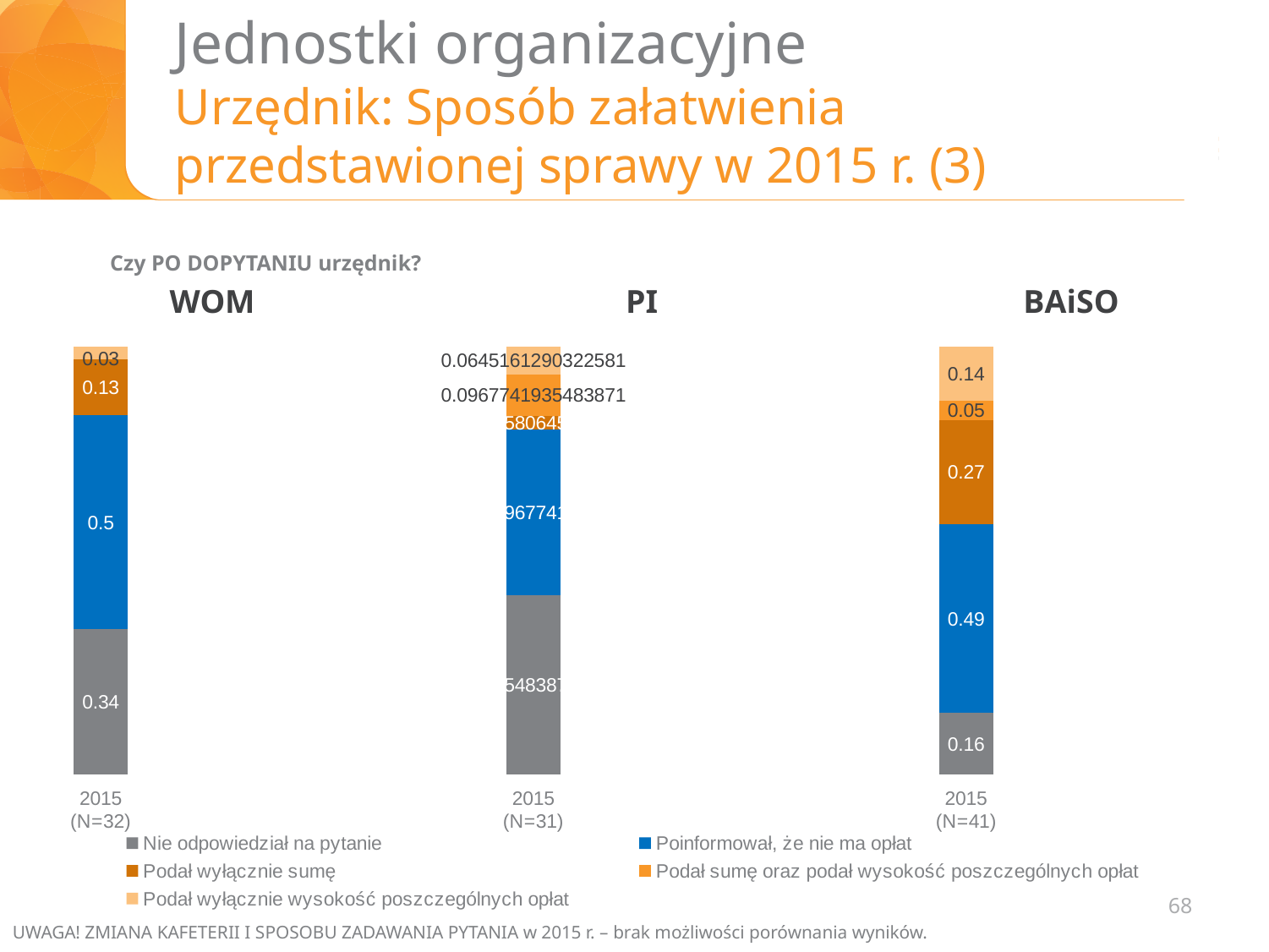
How many series does the legend list? 5 In the BAiSO chart, what is the difference between 'Poinformował, że nie ma opłat' and 'Nie odpowiedział na pytanie'? 0.33 In the WOM chart, what is the difference between 'Poinformował, że nie ma opłat' and 'Nie odpowiedział na pytanie'? 0.16 Which is larger: the value for 'Nie odpowiedział na pytanie' in the WOM chart or in the BAiSO chart? WOM In the WOM chart, what is the value for 'Poinformował, że nie ma opłat'? 0.5 In the BAiSO chart, what is the value for 'Podał wyłącznie sumę'? 0.27 In the WOM chart, which category has the largest share of the bar? Poinformował, że nie ma opłat In the BAiSO chart, which category has the largest value? Poinformował, że nie ma opłat In the WOM chart, what is the value for 'Nie odpowiedział na pytanie'? 0.34 What kind of chart is used for WOM, PI and BAiSO? Stacked bar chart In the WOM chart, which category has the smallest value? Podał wyłącznie wysokość poszczególnych opłat In the BAiSO chart, what is the value for 'Nie odpowiedział na pytanie'? 0.16